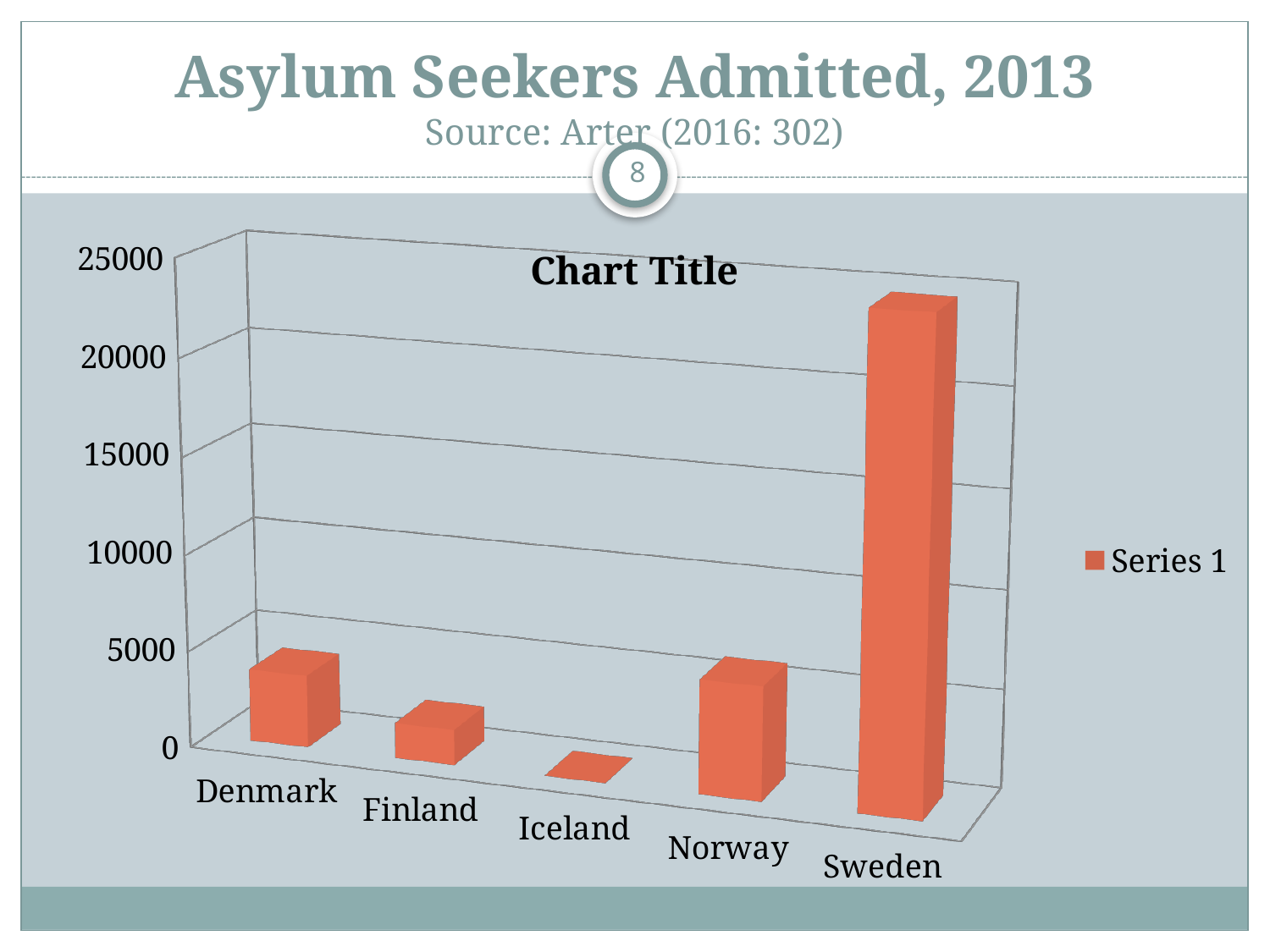
How many countries are shown on the x axis of the chart? 5 Is the value for Finland greater or less than 5000? less Is the value for Sweden greater or less than 20000? greater Which country has the lowest bar in the chart? Iceland Which country has the highest bar in the chart? Sweden How many series does the chart legend list? 1 Is the value for Denmark greater or less than 5000? less What is the name of the series shown in the chart legend? Series 1 Which is larger, the value for Denmark or the value for Finland? Denmark What kind of chart is shown on the slide? Bar chart Which is larger, the value for Finland or the value for Iceland? Finland